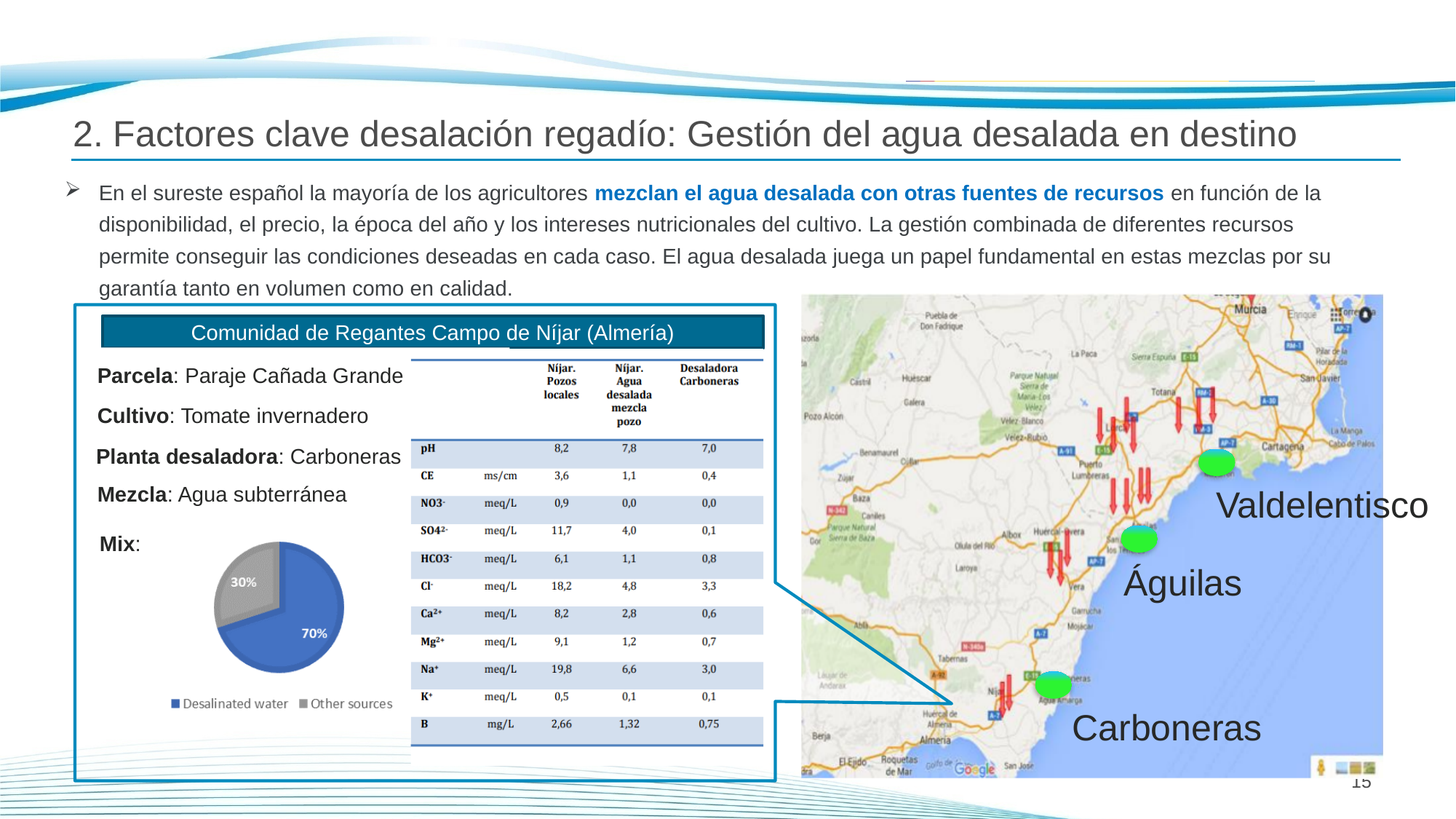
In the "Mix" pie chart, what share is Desalinated water? 70% In the "Mix" pie chart, which slice is the largest? Desalinated water In the "Mix" pie chart, which slice is the smallest? Other sources In the "Mix" pie chart, what is the difference in percentage points between Desalinated water and Other sources? 40 In the "Mix" pie chart, what share is Other sources? 30% How many slices does the "Mix" pie chart have? 2 In the "Mix" pie chart, what colour is the Other sources slice? grey In the "Mix" pie chart, what colour is the Desalinated water slice? blue In the "Mix" pie chart, which is larger: Desalinated water or Other sources? Desalinated water How many entries does the legend of the "Mix" pie chart list? 2 What kind of chart is the "Mix" chart on the slide? pie chart